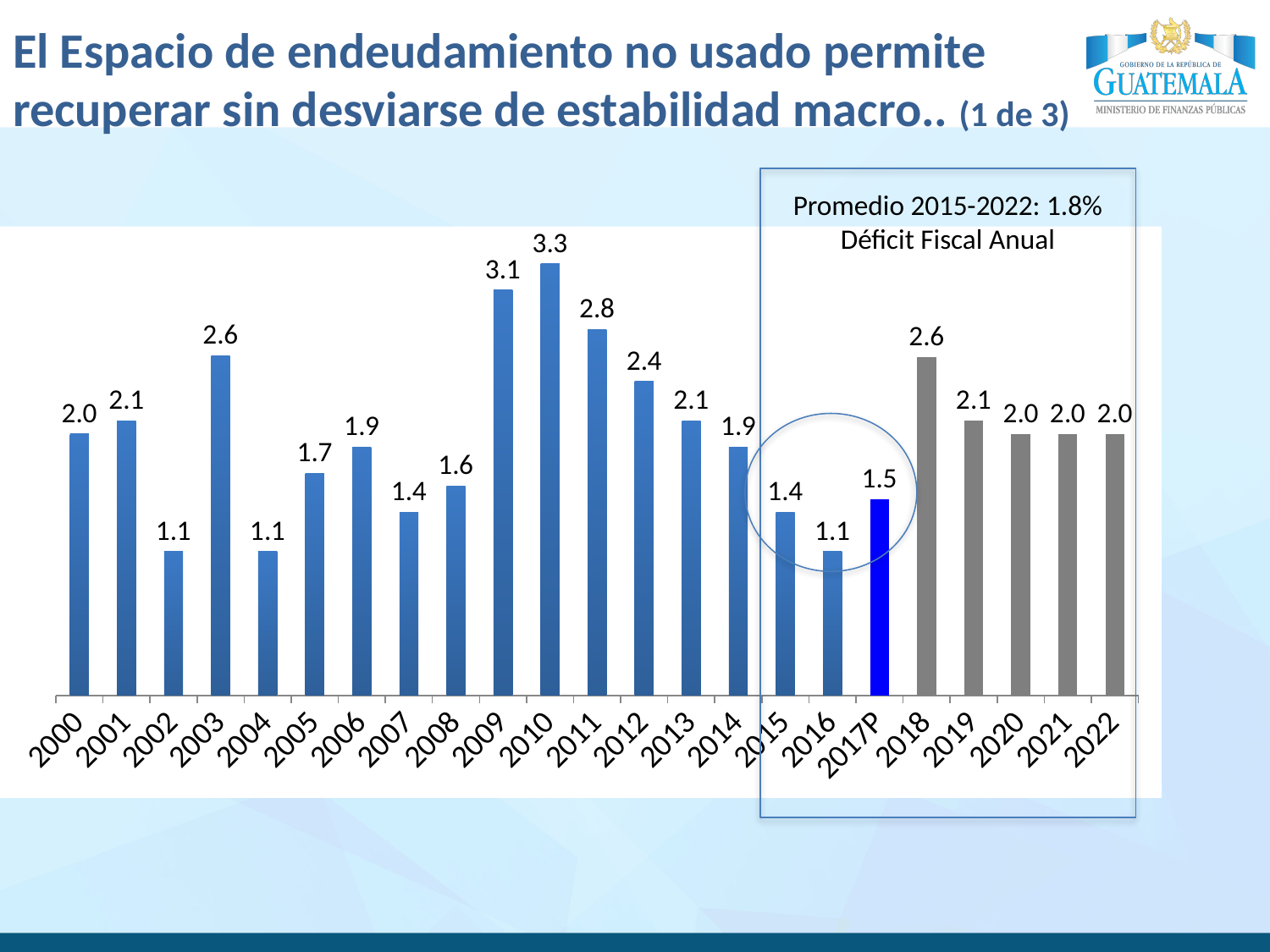
What is the value for 2010? 3.3 What type of chart is shown on the slide? bar chart What is the value for 2018? 2.6 What is the difference between the values for 2010 and 2016? 2.2 Which year has the highest value? 2010 What average for 2015-2022 is stated in the box on the chart? 1.8% Which is larger, the value for 2009 or the value for 2011? 2009 How many years (bars) are shown in the chart? 23 Do the values rise or fall from 2010 to 2016? fall What is the value for 2016? 1.1 What is the value for 2017P? 1.5 What is the lowest value shown in the chart? 1.1